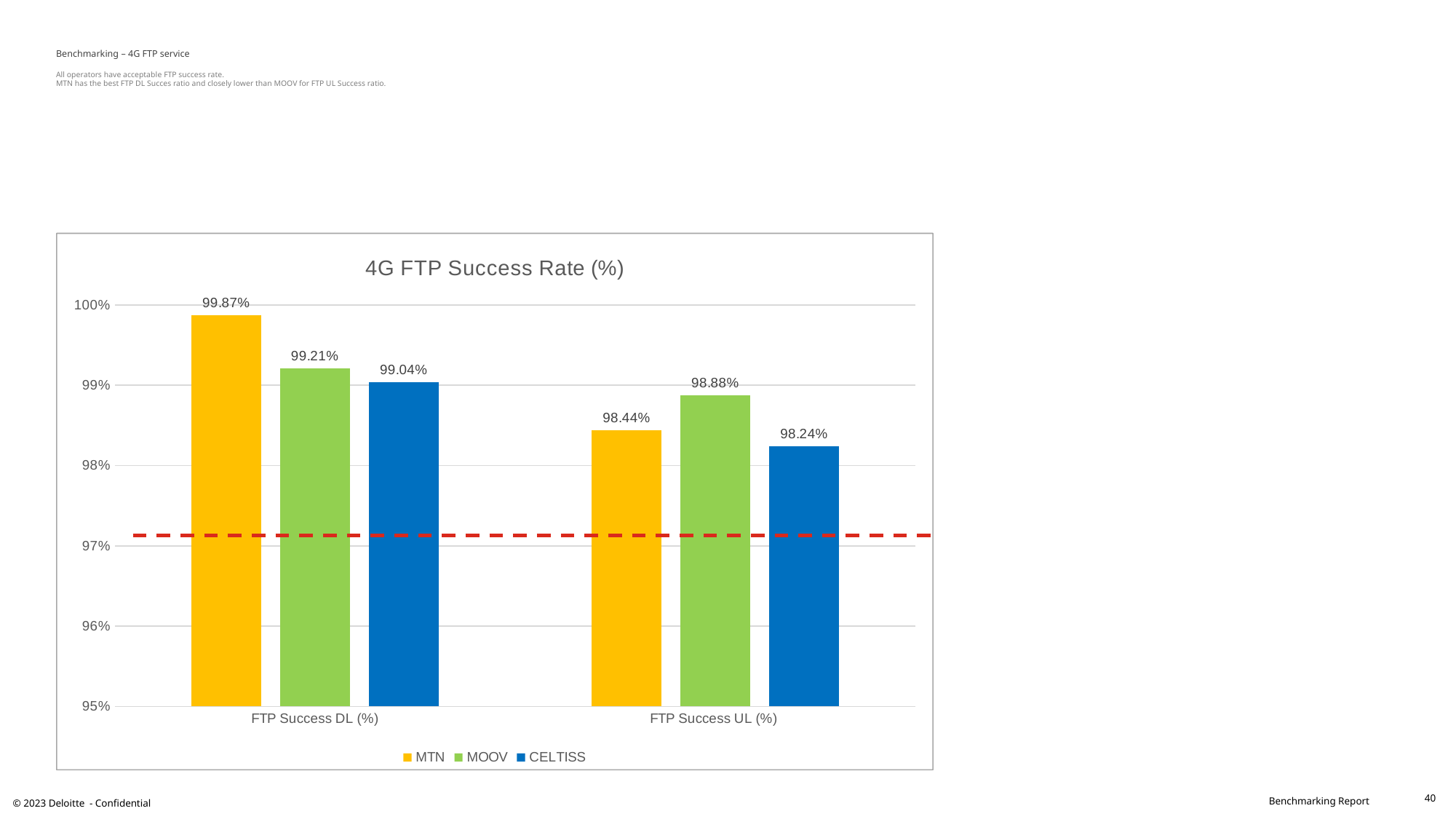
What is the title of the chart? 4G FTP Success Rate (%) What kind of chart is shown on the slide? bar chart What is the difference between MTN's and CELTISS's FTP Success DL (%) values? 0.83% What is the FTP Success UL (%) value for MOOV? 98.88% Which operator has the highest FTP Success DL (%)? MTN What is the FTP Success DL (%) value for MTN? 99.87% Which is larger for MOOV: FTP Success DL (%) or FTP Success UL (%)? FTP Success DL (%) Is the FTP Success UL (%) value for MTN greater or less than 99%? less What is the FTP Success UL (%) value for CELTISS? 98.24% How many series does the legend list? 3 How many categories are shown on the x axis? 2 Which operator has the lowest FTP Success UL (%)? CELTISS